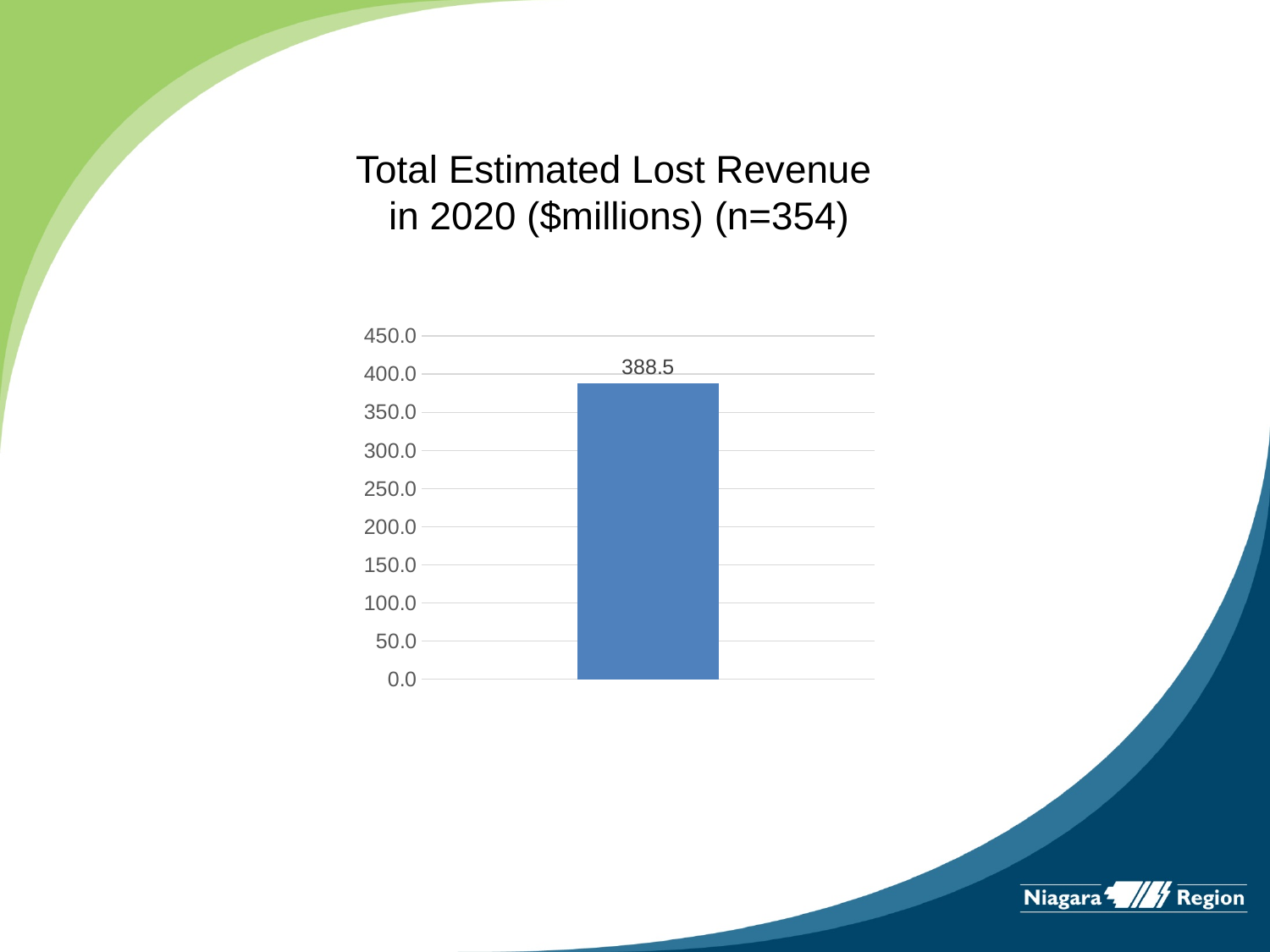
Is the value of the bar greater or less than 350.0? greater What is the highest value shown on the vertical axis? 450.0 What is the title of the chart? Total Estimated Lost Revenue in 2020 ($millions) (n=354) Is the value of the bar greater or less than 400.0? less What is the value shown by the single bar in the chart? 388.5 What kind of chart is shown on the slide? bar chart How many bars are plotted in the chart? 1 What is the sample size (n) stated in the chart title? 354